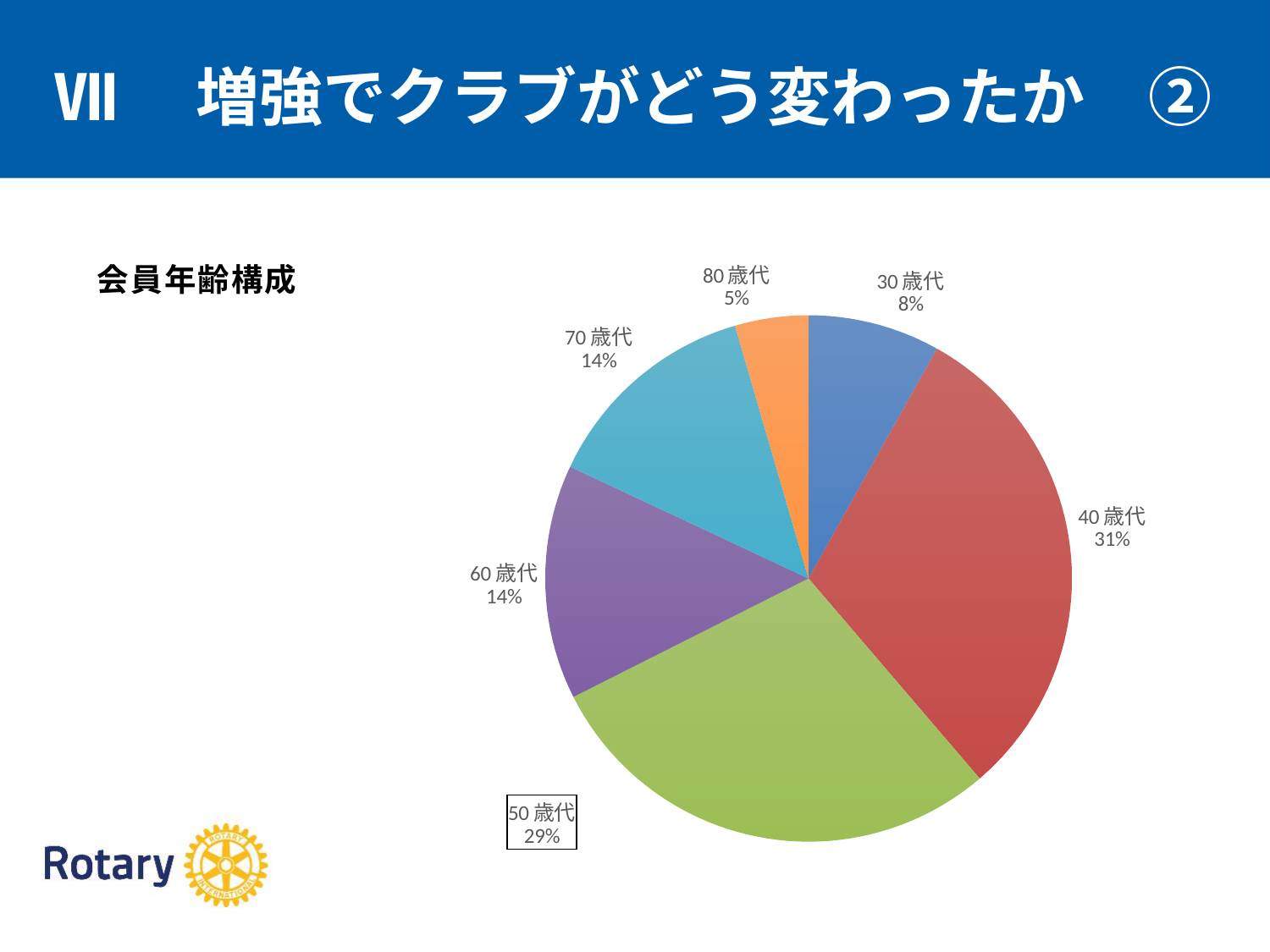
Which is larger, the share for 30歳代 or the share for 80歳代? 30歳代 What is the title of the chart on the slide? 会員年齢構成 What share of members are in the 40歳代 group? 31% What is the combined share of the 60歳代 and 70歳代 groups? 28% What share of members are in the 50歳代 group? 29% What kind of chart is shown on the slide? pie chart Which age group has the largest share of members? 40歳代 How many age groups are shown in the pie chart? 6 What is the difference in percentage points between the 40歳代 and 50歳代 shares? 2 Which age group has the smallest share of members? 80歳代 What share of members are in the 30歳代 group? 8% What share of members are in the 80歳代 group? 5%